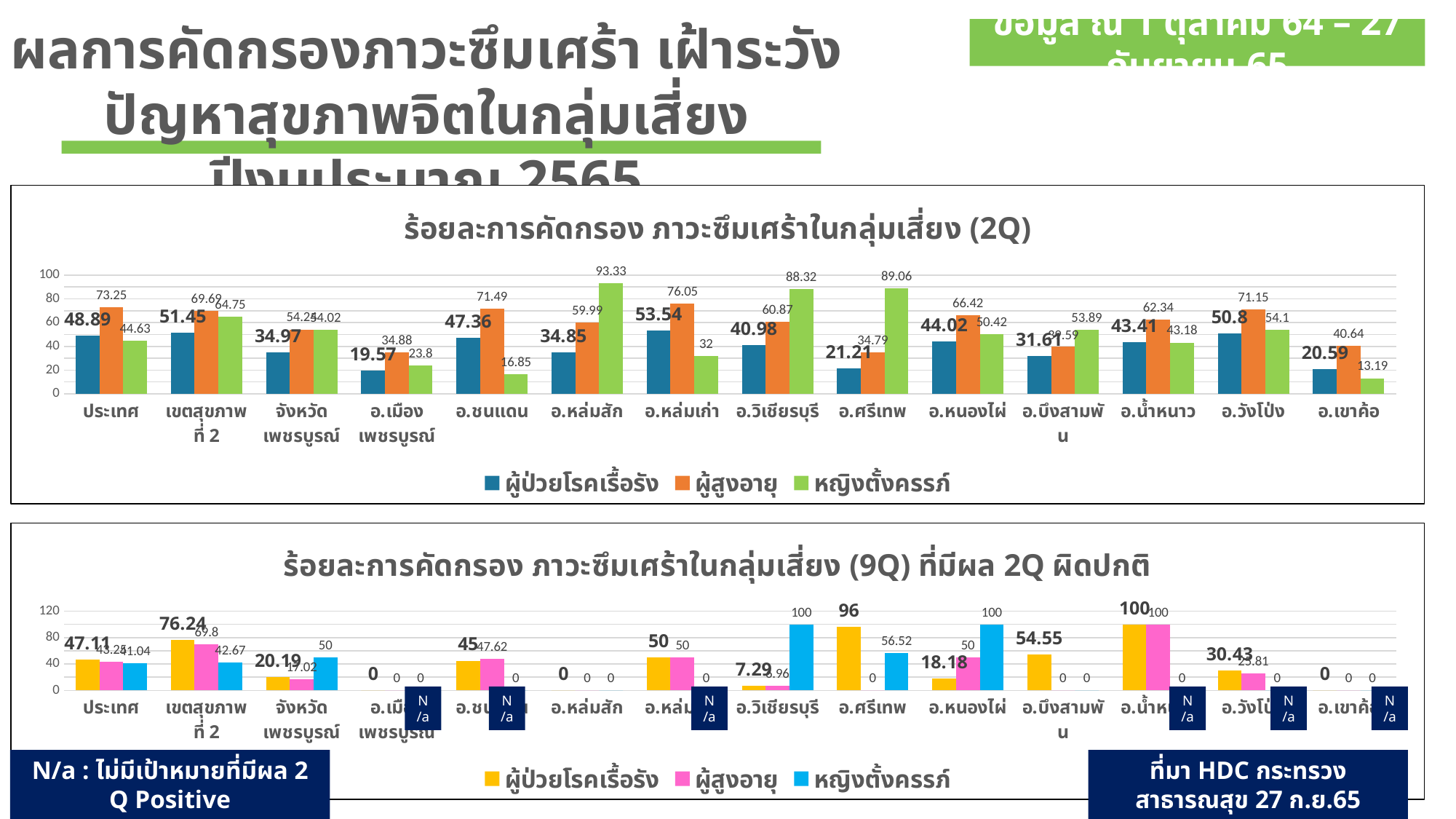
How many series does the legend of the bottom chart (9Q) list? 3 In the bottom chart (9Q), what is the value for หญิงตั้งครรภ์ in อ.ศรีเทพ? 56.52 In the top chart (2Q), which category has the lowest value for ผู้ป่วยโรคเรื้อรัง? อ.เมืองเพชรบูรณ์ In the top chart (2Q), which category has the highest value for หญิงตั้งครรภ์? อ.หล่มสัก In the bottom chart (9Q), which is larger in จังหวัดเพชรบูรณ์: ผู้ป่วยโรคเรื้อรัง or หญิงตั้งครรภ์? หญิงตั้งครรภ์ In the top chart (2Q), what is the value for ผู้สูงอายุ in ประเทศ? 73.25 In the top chart (2Q), which is larger in อ.ศรีเทพ: ผู้ป่วยโรคเรื้อรัง or หญิงตั้งครรภ์? หญิงตั้งครรภ์ What kind of chart is the bottom chart (9Q)? Bar chart How many categories are shown on the x axis of the top chart (2Q)? 14 In the top chart (2Q), what is the difference between ผู้สูงอายุ and ผู้ป่วยโรคเรื้อรัง in อ.ชนแดน? 24.13 In the bottom chart (9Q), what is the value for ผู้ป่วยโรคเรื้อรัง in เขตสุขภาพที่ 2? 76.24 In the top chart (2Q), what is the value for หญิงตั้งครรภ์ in อ.หล่มสัก? 93.33